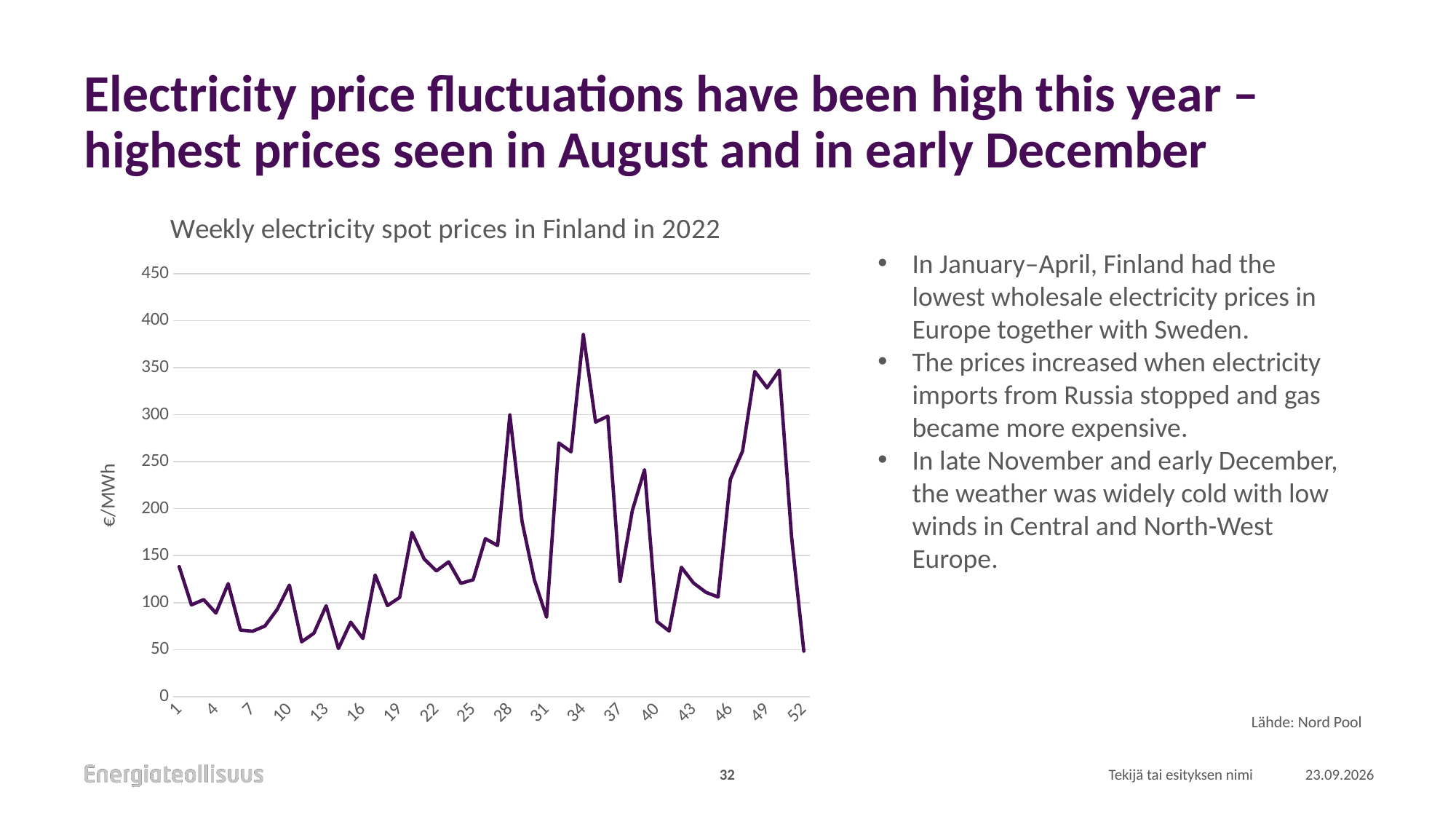
Which week has the higher price, week 34 or week 48? week 34 Is the value for week 31 greater or less than 100? less Do the prices rise or fall from week 48 to week 52? fall In which week does the electricity spot price reach its highest value? 34 What unit is shown on the vertical axis of the chart? €/MWh Is the value for week 34 greater or less than 350? greater Is the value for week 52 greater or less than 100? less What is the title of the chart? Weekly electricity spot prices in Finland in 2022 What kind of chart is shown on the slide? line chart